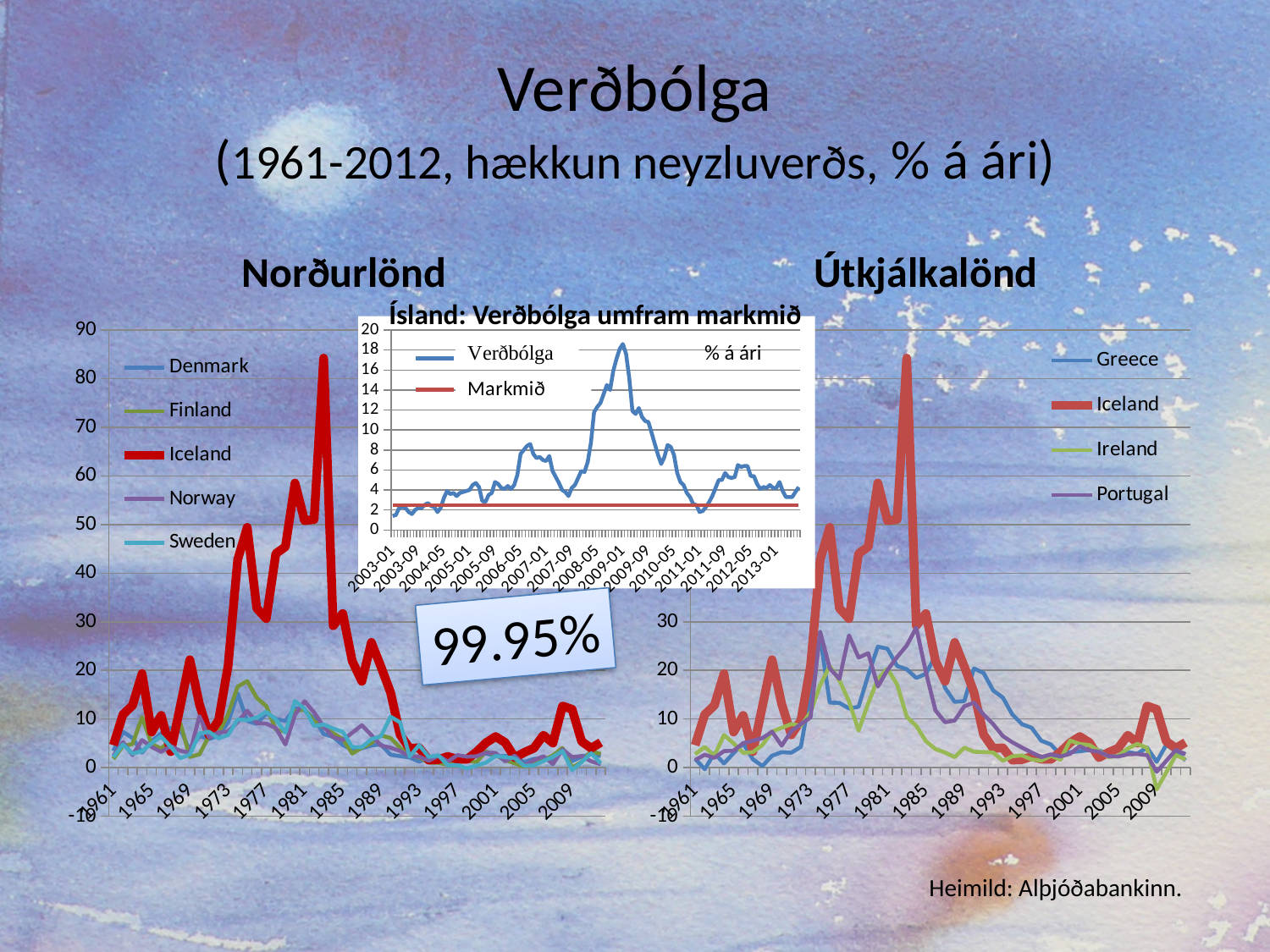
In the inset chart 'Ísland: Verðbólga umfram markmið', is the peak of the Verðbólga line around 2009-01 greater or less than 16? greater In the Norðurlönd chart, which country has the highest peak value? Iceland How many series does the legend of the Norðurlönd chart list? 5 How many series does the legend of the inset chart 'Ísland: Verðbólga umfram markmið' list? 2 In the Útkjálkalönd chart, is Iceland's peak value in the early 1980s greater or less than 30? greater What is the title of the inset chart placed between the two main charts? Ísland: Verðbólga umfram markmið What kind of chart is the Norðurlönd chart on the left? line chart In the Norðurlönd chart, do Iceland's values rise or fall from 1983 to 1997? fall In the Norðurlönd chart, which is larger around 1983: the value for Iceland or the value for Denmark? Iceland In the Norðurlönd chart, is Iceland's peak value in the early 1980s greater or less than 80? greater In the Útkjálkalönd chart, which country has the highest peak value? Iceland How many series does the legend of the Útkjálkalönd chart list? 4